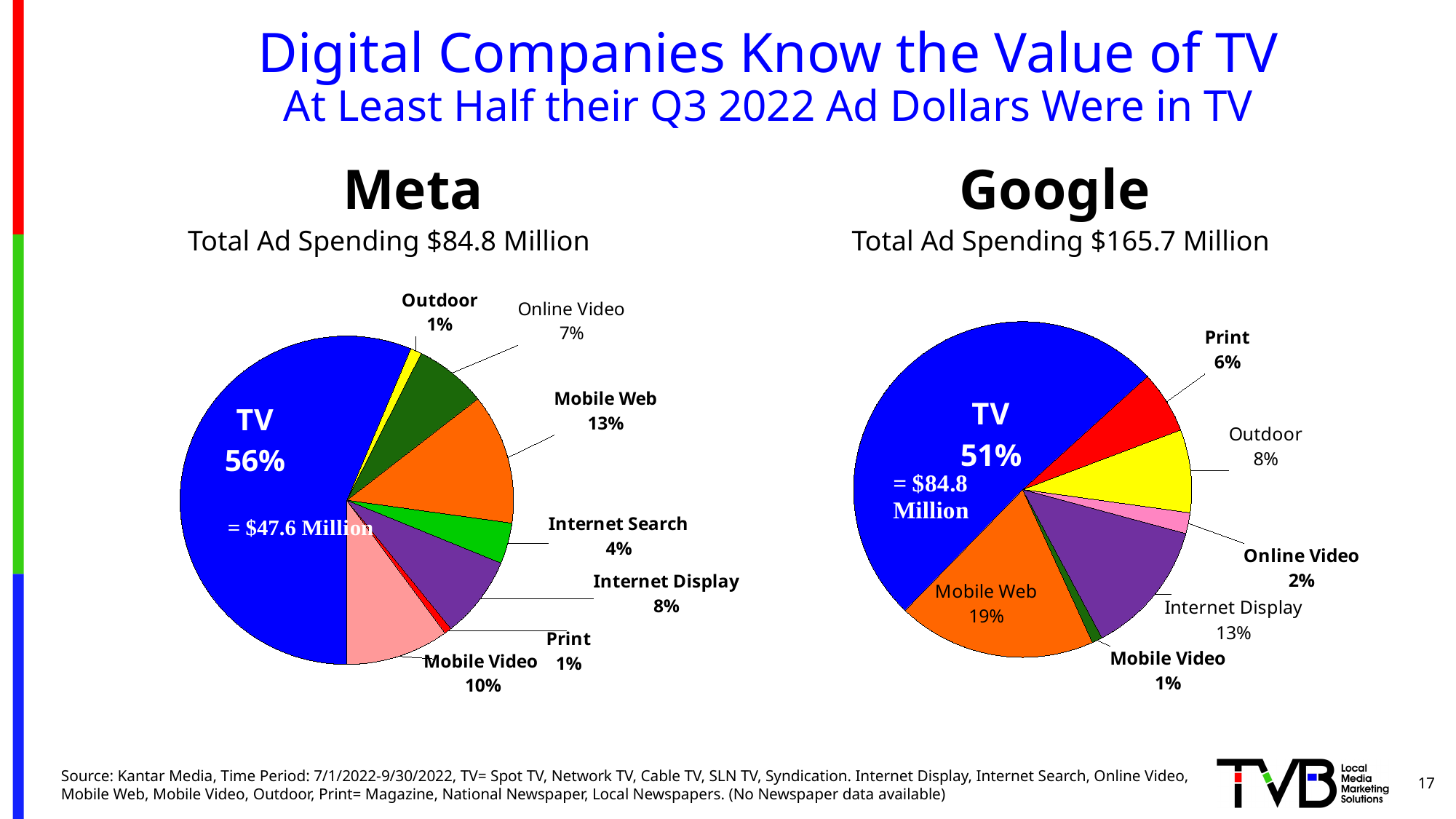
In the Meta pie chart, what share of ad spending went to TV? 56% How many categories are shown in the Google pie chart? 7 What total ad spending is stated above the Google pie chart? $165.7 Million Which is larger: the Outdoor share in the Meta chart or the Outdoor share in the Google chart? Google In the Meta pie chart, which category has the largest share? TV In the Google pie chart, which category has the smallest share? Mobile Video In the Meta pie chart, what is the difference between the Mobile Web share and the Mobile Video share? 3% How many categories are shown in the Meta pie chart? 8 What type of chart is used for the Meta ad spending breakdown? Pie chart In the Google pie chart, what is the difference between the TV share and the Mobile Web share? 32% In the Google pie chart, what share of ad spending went to Mobile Web? 19% In the Google pie chart, what percentage is shown for Internet Display? 13%